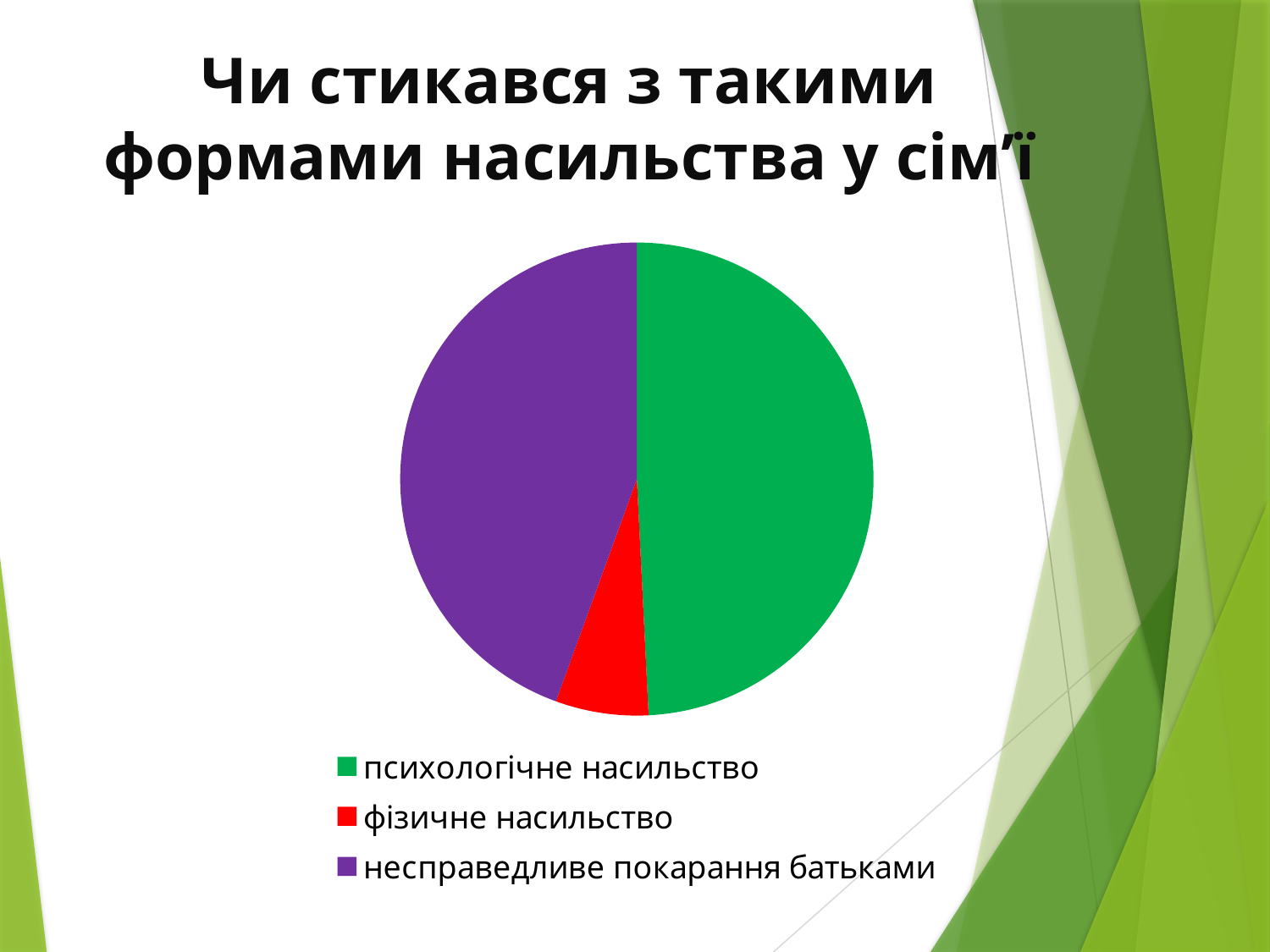
What colour is the slice for фізичне насильство in the pie chart? red Which slice is larger: несправедливе покарання батьками or фізичне насильство? несправедливе покарання батьками What is the title of the slide containing the pie chart? Чи стикався з такими формами насильства у сім’ї Which slice is larger: психологічне насильство or фізичне насильство? психологічне насильство Which category has the largest slice of the pie chart? психологічне насильство How many entries does the legend of the pie chart list? 3 How many slices does the pie chart have? 3 What kind of chart is shown on the slide? pie chart Which category has the smallest slice of the pie chart? фізичне насильство